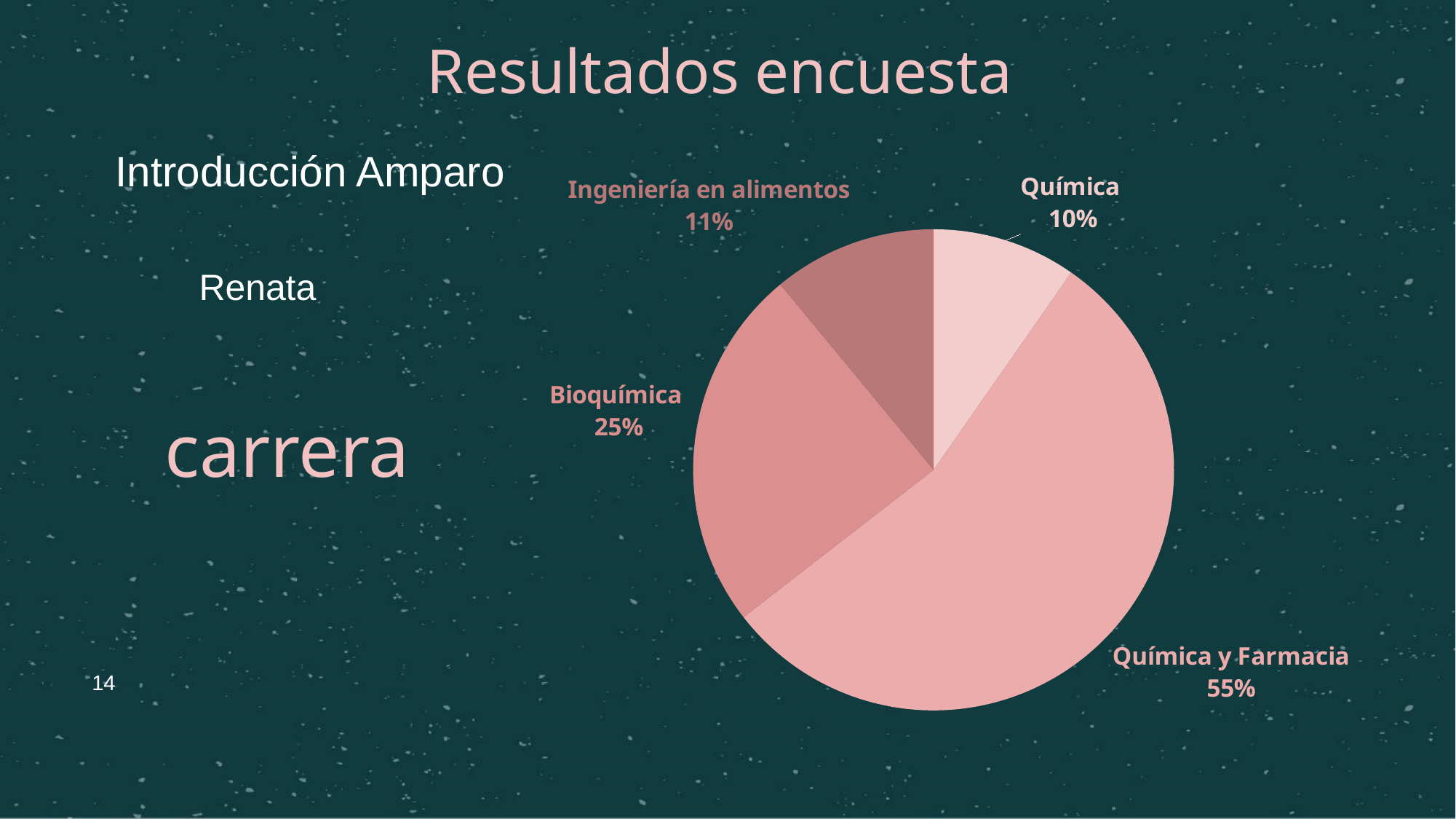
Which category has the smallest slice of the pie? Química What share of the pie does Ingeniería en alimentos have? 11% What share of the pie does Química have? 10% What is the combined share of Bioquímica and Ingeniería en alimentos? 36% Which is larger, the share for Bioquímica or the share for Ingeniería en alimentos? Bioquímica What share of the pie does Química y Farmacia have? 55% How many categories are shown in the pie chart? 4 What is the difference in percentage points between Química y Farmacia and Bioquímica? 30 What is the title of the slide containing the chart? Resultados encuesta What share of the pie does Bioquímica have? 25% What kind of chart is shown on the slide? Pie chart Which category has the largest slice of the pie? Química y Farmacia